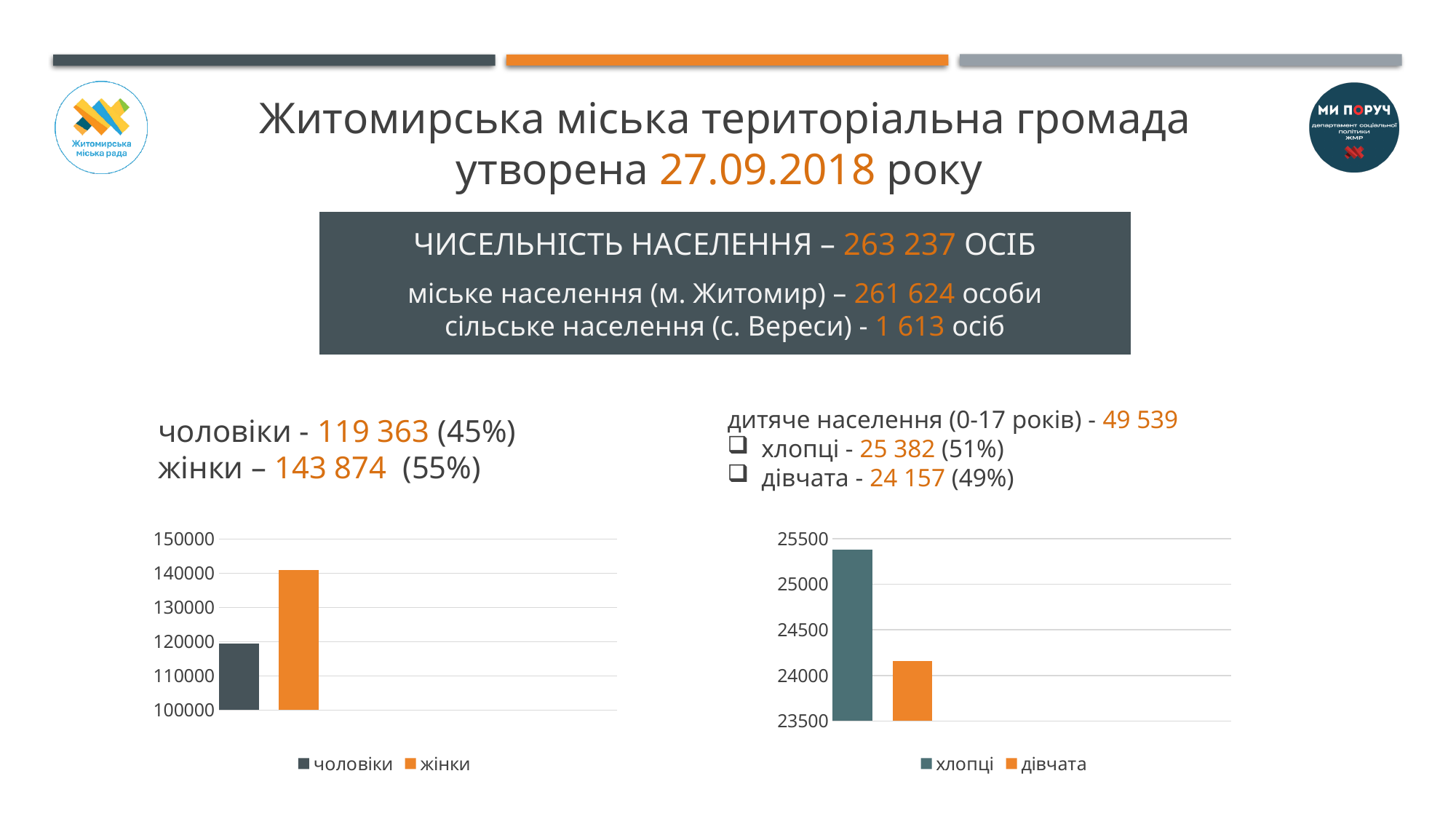
On the right chart (хлопці / дівчата), what is the value for дівчата as stated on the slide? 24 157 On the left chart (чоловіки / жінки), is the value for жінки greater or less than 140000? greater On the right chart (хлопці / дівчата), is the value for дівчата greater or less than 24500? less On the right chart (хлопці / дівчата), is the value for хлопці greater or less than 25000? greater On the left chart (чоловіки / жінки), what kind of chart is shown? bar chart On the left chart (чоловіки / жінки), what is the value for чоловіки as stated on the slide? 119 363 On the left chart (чоловіки / жінки), what is the difference between жінки (143 874) and чоловіки (119 363)? 24 511 On the left chart (чоловіки / жінки), how many series does the legend list? 2 On the left chart (чоловіки / жінки), which series has the taller bar? жінки On the right chart (хлопці / дівчата), what colour is the bar for дівчата? orange On the right chart (хлопці / дівчата), which series has the lower bar? дівчата